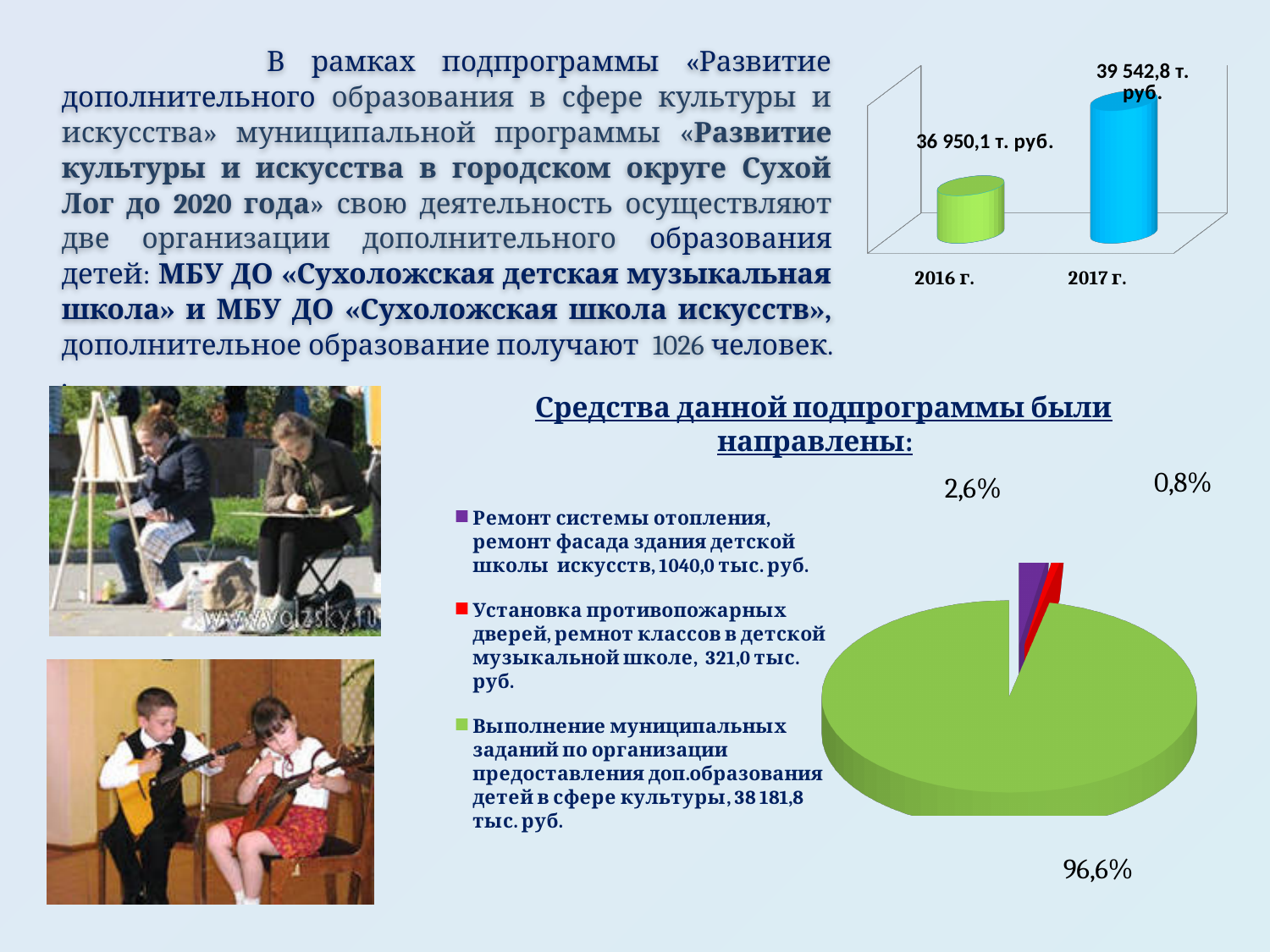
What type of chart is shown at the top right of the slide? Bar chart How many entries does the legend of the pie chart at the bottom right list? 3 What type of chart is shown at the bottom right of the slide? Pie chart In the bar chart at the top right, which year has the higher value? 2017 г. In the bar chart at the top right, what is the value for 2017 г.? 39 542,8 т. руб. In the bar chart at the top right, what is the value for 2016 г.? 36 950,1 т. руб. In the pie chart at the bottom right, what share is shown for the largest slice? 96,6% In the pie chart at the bottom right, which is larger: the 2,6% slice or the 0,8% slice? 2,6% In the bar chart at the top right, by how much does the 2017 г. value exceed the 2016 г. value? 2 592,7 т. руб. In the pie chart at the bottom right, what is the smallest percentage shown? 0,8% In the bar chart at the top right, how many bars are shown? 2 In the bar chart at the top right, do the values rise or fall from 2016 г. to 2017 г.? Rise